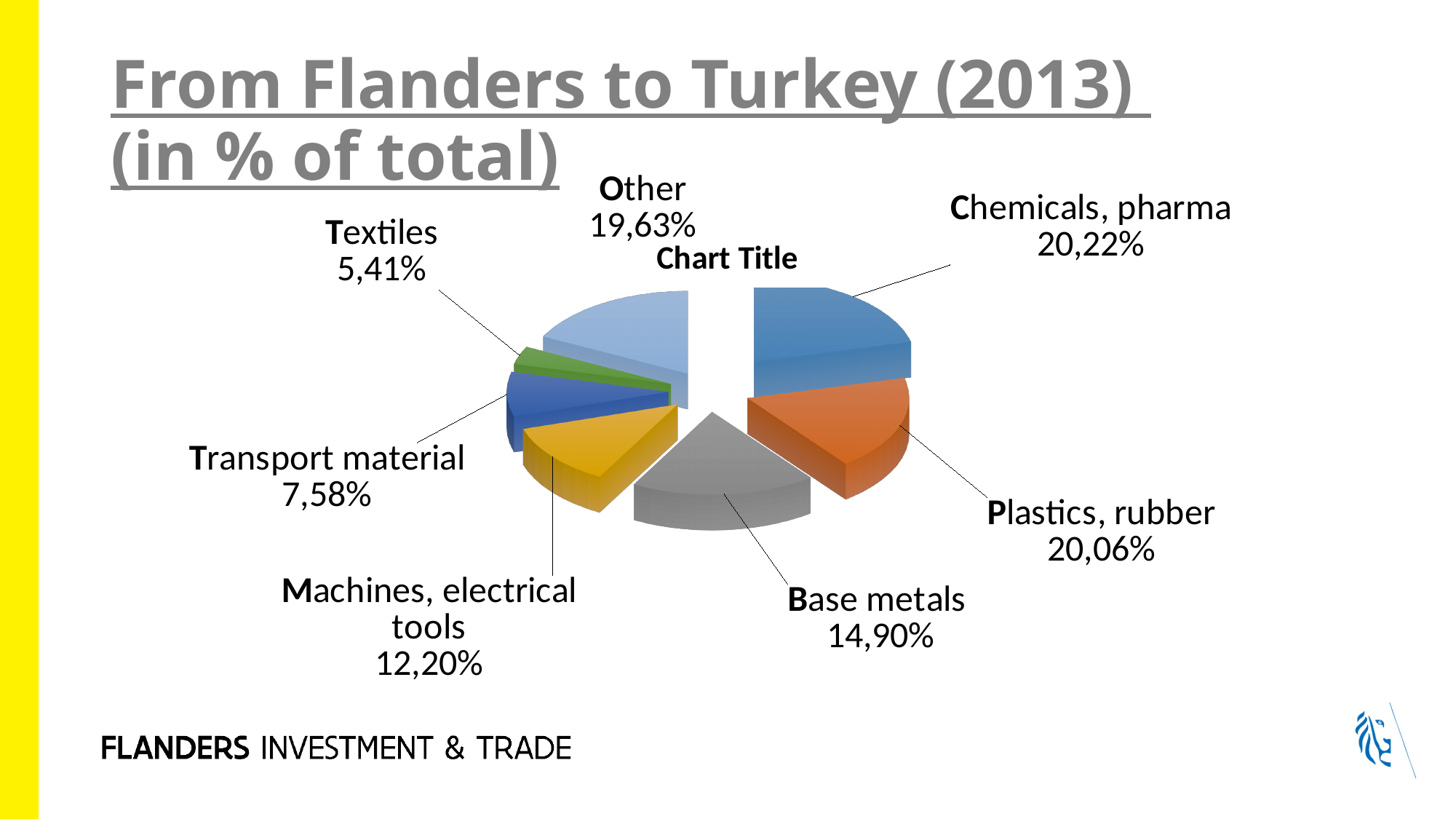
How many slices does the pie chart have? 7 What is the difference between the shares of Machines, electrical tools and Transport material? 4,62% What is the value for Transport material? 7,58% Which category has the smallest share of the pie? Textiles What is the title of the slide? From Flanders to Turkey (2013) (in % of total) What kind of chart is shown on the slide? pie chart Which is larger, the share of Other or the share of Base metals? Other What is the difference between the shares of Base metals and Textiles? 9,49% What share of the pie does Chemicals, pharma have? 20,22% What is the value for Base metals? 14,90% Which category has the largest share of the pie? Chemicals, pharma What is the value for Machines, electrical tools? 12,20%